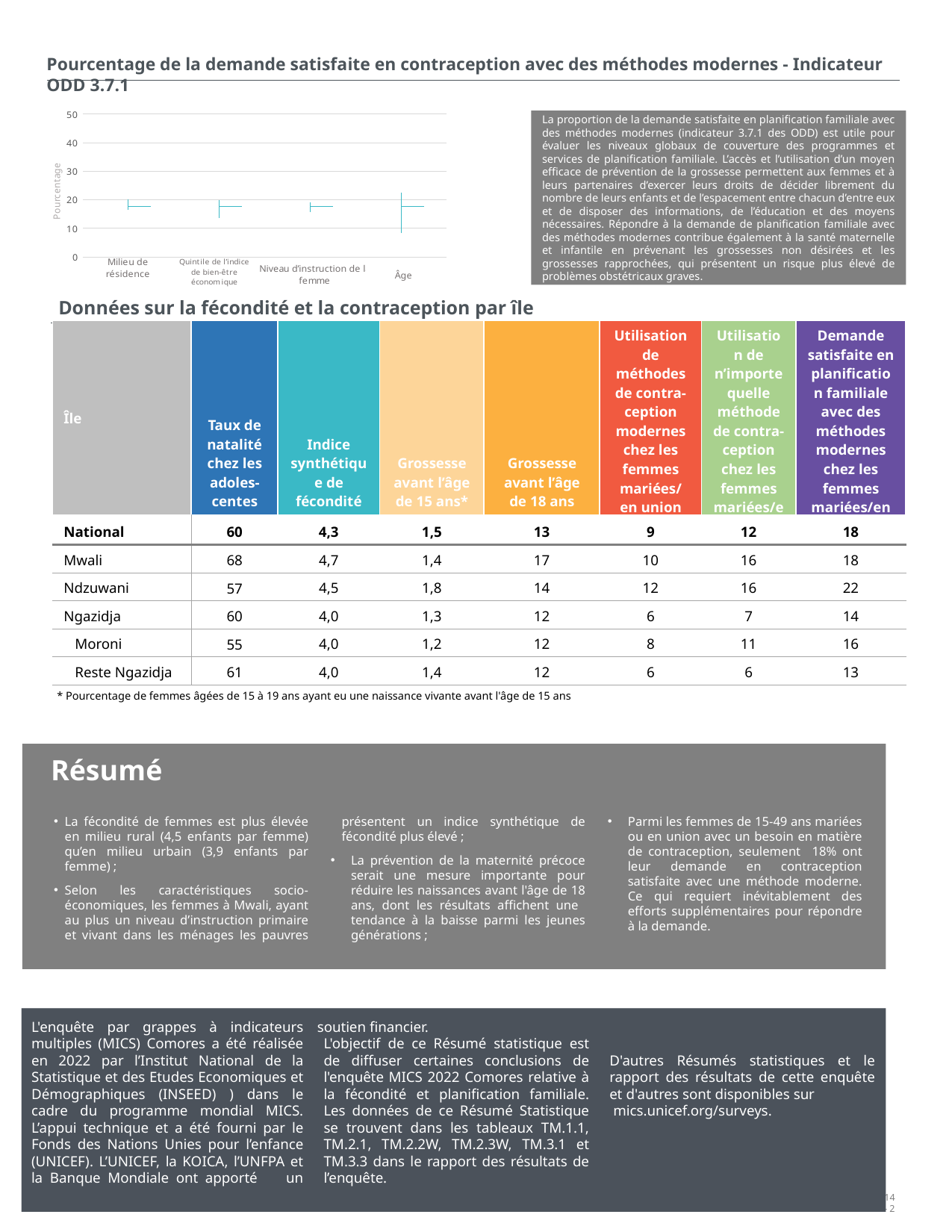
Is the value for Quintile de l'indice de bien-être économique greater or less than 40? less What is the highest value shown on the y axis of the chart? 50 Is the value for Âge greater or less than 30? less Which category in the chart shows the widest vertical range? Âge Do the values plotted in the chart rise, fall, or stay roughly flat across the categories from left to right? roughly flat Is the value for Milieu de résidence greater or less than 30? less What is the title of the chart on the slide? Pourcentage de la demande satisfaite en contraception avec des méthodes modernes - Indicateur ODD 3.7.1 How many categories are shown on the x axis of the chart? 4